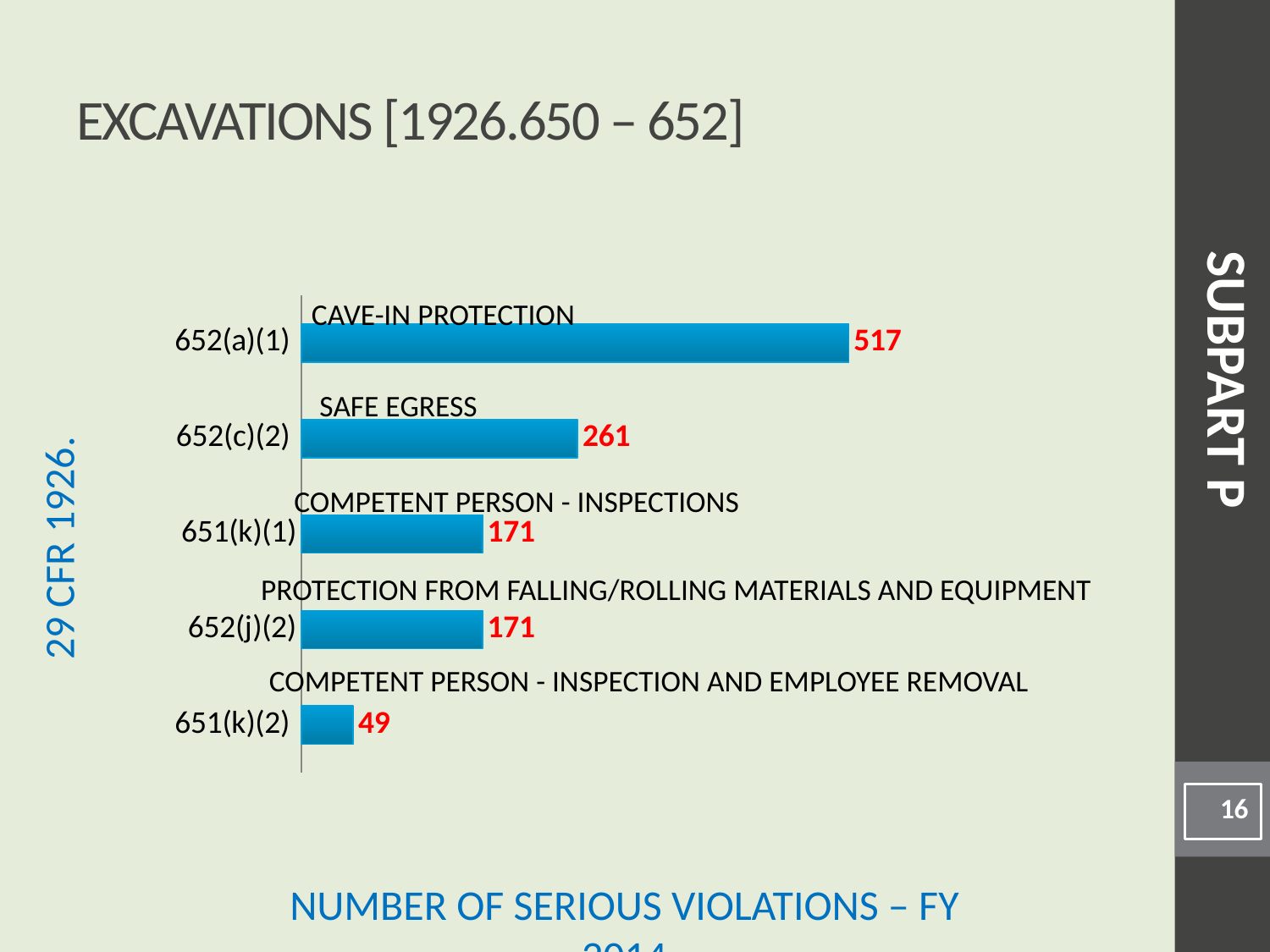
How many categories are shown in the chart? 5 What is the number of serious violations for 651(k)(2)? 49 What description is given for the 652(a)(1) bar? CAVE-IN PROTECTION Which category has the highest number of serious violations? 652(a)(1) Which has a larger value, 652(c)(2) or 651(k)(1)? 652(c)(2) What is the value shown for 651(k)(1)? 171 What is the number of serious violations for 652(a)(1)? 517 What is the difference between the values for 652(a)(1) and 652(c)(2)? 256 What kind of chart is shown on the slide? Bar chart What is the difference between the values for 652(j)(2) and 651(k)(2)? 122 Which category has the lowest number of serious violations? 651(k)(2) What is the number of serious violations for 652(c)(2)? 261